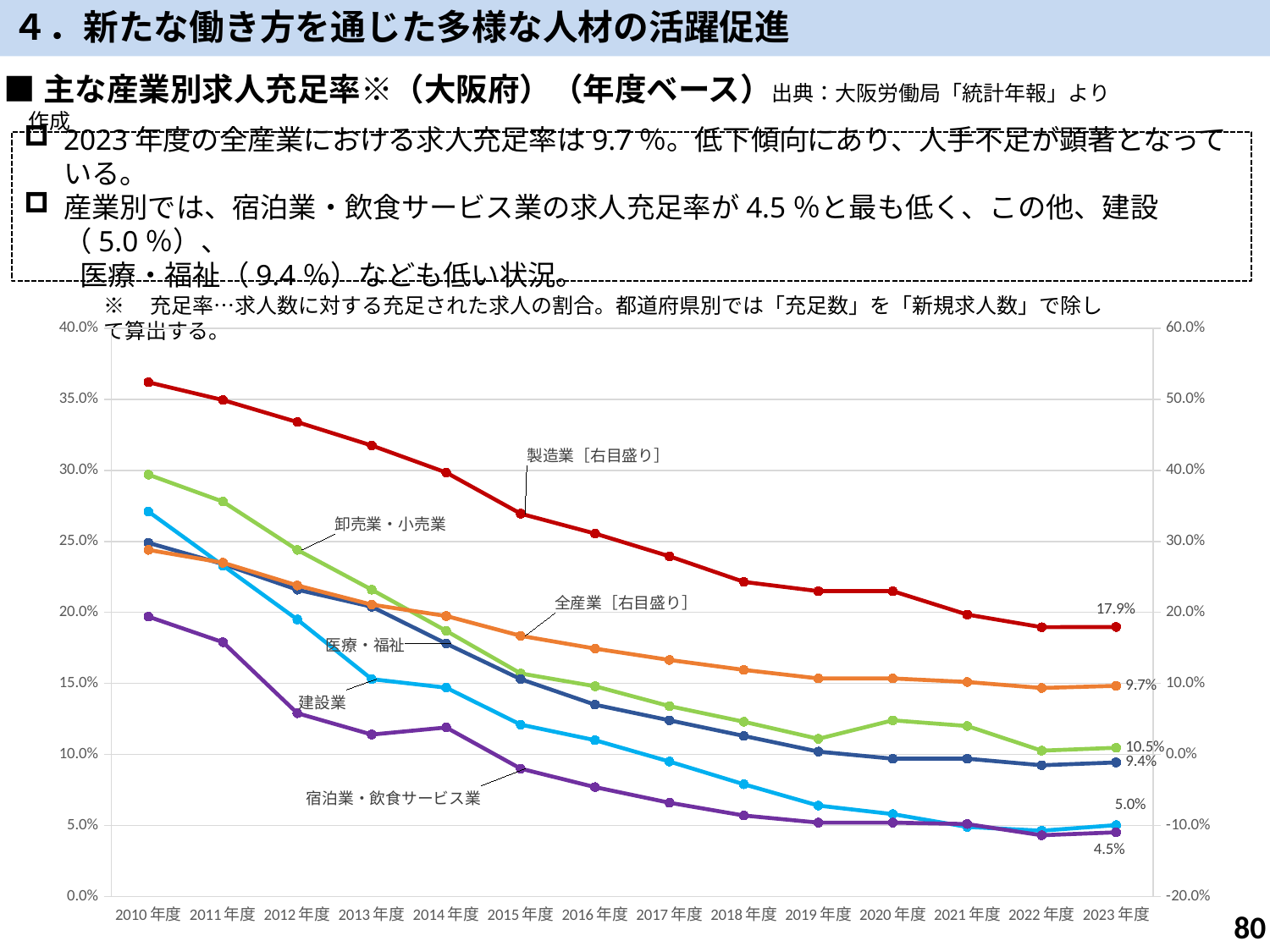
Which industry has the lowest value in 2023年度? 宿泊業・飲食サービス業 What is the value for 宿泊業・飲食サービス業 in 2023年度? 4.5% Does the 製造業 line rise or fall from 2010年度 to 2023年度? falls What is the value for 全産業 in 2023年度? 9.7% How many fiscal years are shown on the x axis? 14 What kind of chart is shown on the slide? line chart What is the value for 卸売業・小売業 in 2023年度? 10.5% Is the value for 卸売業・小売業 in 2010年度 greater or less than 25.0%? greater What is the difference between the 2023年度 values for 建設業 and 宿泊業・飲食サービス業? 0.5 percentage points What is the value for 医療・福祉 in 2023年度? 9.4% In 2023年度, which is larger: the value for 卸売業・小売業 or the value for 医療・福祉? 卸売業・小売業 What is the value for 製造業 in 2023年度? 17.9%